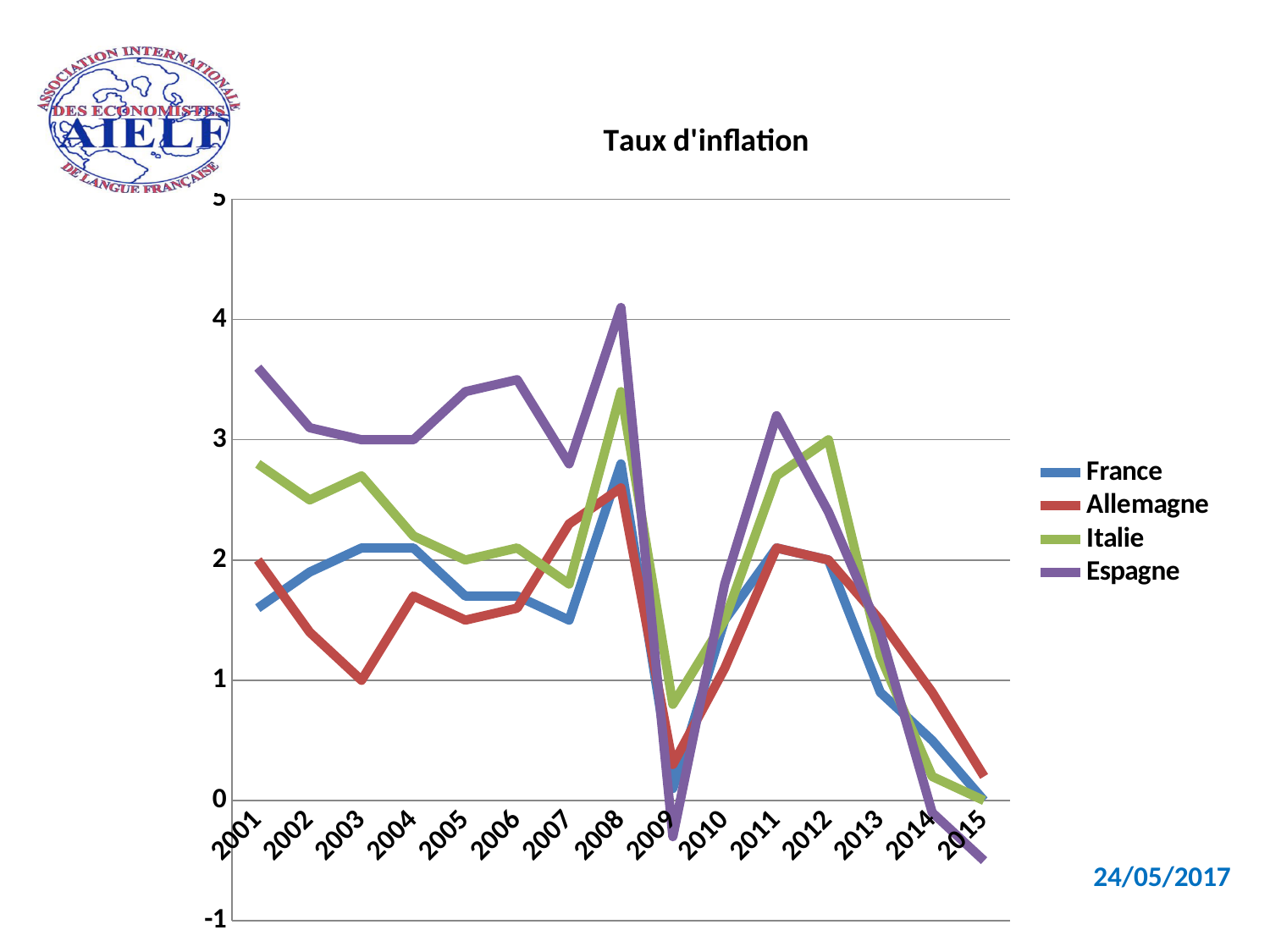
Which country had the highest inflation rate in 2001? Espagne What colour is the line for Espagne? purple What is the title of the chart? Taux d'inflation How many series does the legend list? 4 Is the inflation rate for Espagne in 2001 greater or less than 3? greater Which country had the lowest inflation rate in 2009? Espagne How many years are plotted along the x axis? 15 Does the inflation rate for Espagne rise or fall from 2012 to 2015? fall What kind of chart is shown on the slide? line chart Which country had the highest inflation rate in 2008? Espagne In 2012, which had the higher inflation rate, Italie or France? Italie Is the inflation rate for Allemagne in 2003 greater or less than 2? less